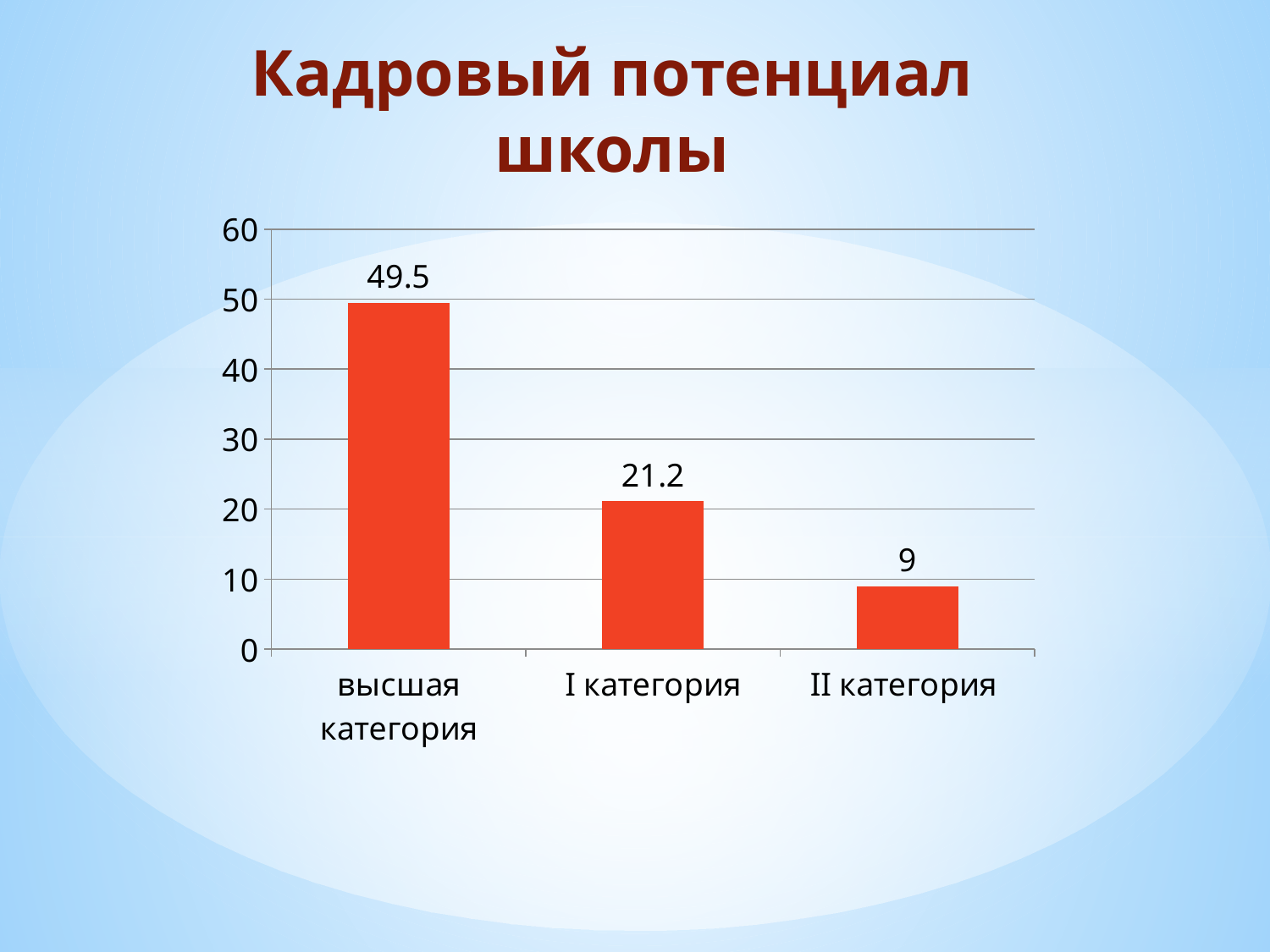
Is the value for высшая категория greater or less than 40? greater What is the value for I категория? 21.2 What kind of chart is shown on the slide? bar chart Which category has the highest value? высшая категория Which is larger, the value for I категория or the value for II категория? I категория What is the value for II категория? 9 What is the value for высшая категория? 49.5 What is the difference between the values for I категория and II категория? 12.2 Which category has the lowest value? II категория How many categories are shown on the chart? 3 Do the values rise or fall from left to right across the categories? fall What is the difference between the values for высшая категория and I категория? 28.3